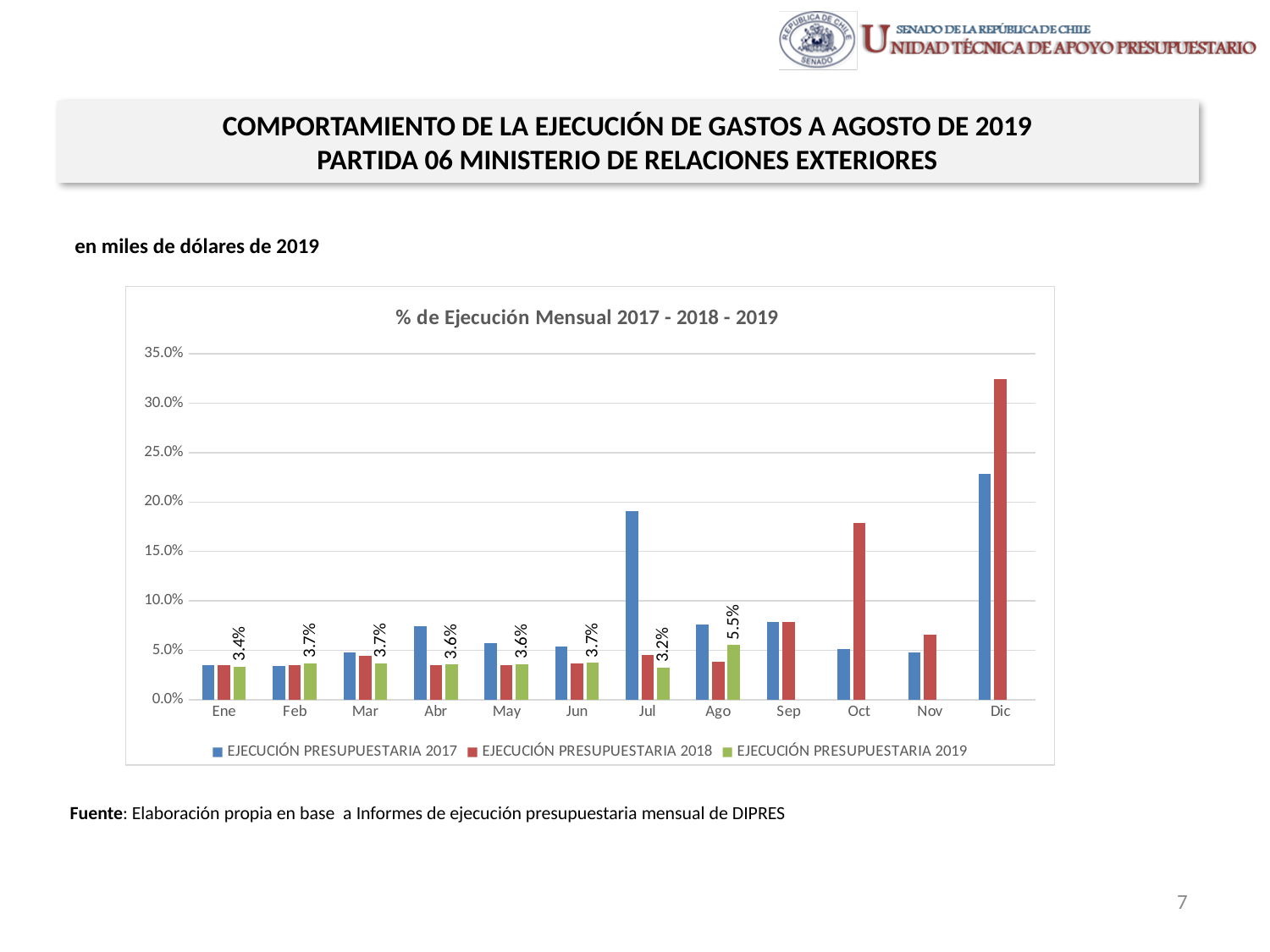
What is the difference between the EJECUCIÓN PRESUPUESTARIA 2019 values for Ago and Jul? 2.3% Is the value for EJECUCIÓN PRESUPUESTARIA 2018 in Dic greater or less than 30.0%? greater How many series does the legend list? 3 Which is larger in Oct: EJECUCIÓN PRESUPUESTARIA 2017 or EJECUCIÓN PRESUPUESTARIA 2018? EJECUCIÓN PRESUPUESTARIA 2018 What is the value for EJECUCIÓN PRESUPUESTARIA 2019 in Ago? 5.5% In which month is the EJECUCIÓN PRESUPUESTARIA 2019 value highest? Ago What is the value for EJECUCIÓN PRESUPUESTARIA 2019 in Jul? 3.2% In which month is the EJECUCIÓN PRESUPUESTARIA 2019 value lowest? Jul What is the title of the chart? % de Ejecución Mensual 2017 - 2018 - 2019 What kind of chart is shown on the slide? Bar chart What is the value for EJECUCIÓN PRESUPUESTARIA 2019 in Ene? 3.4% How many months are shown on the x axis? 12